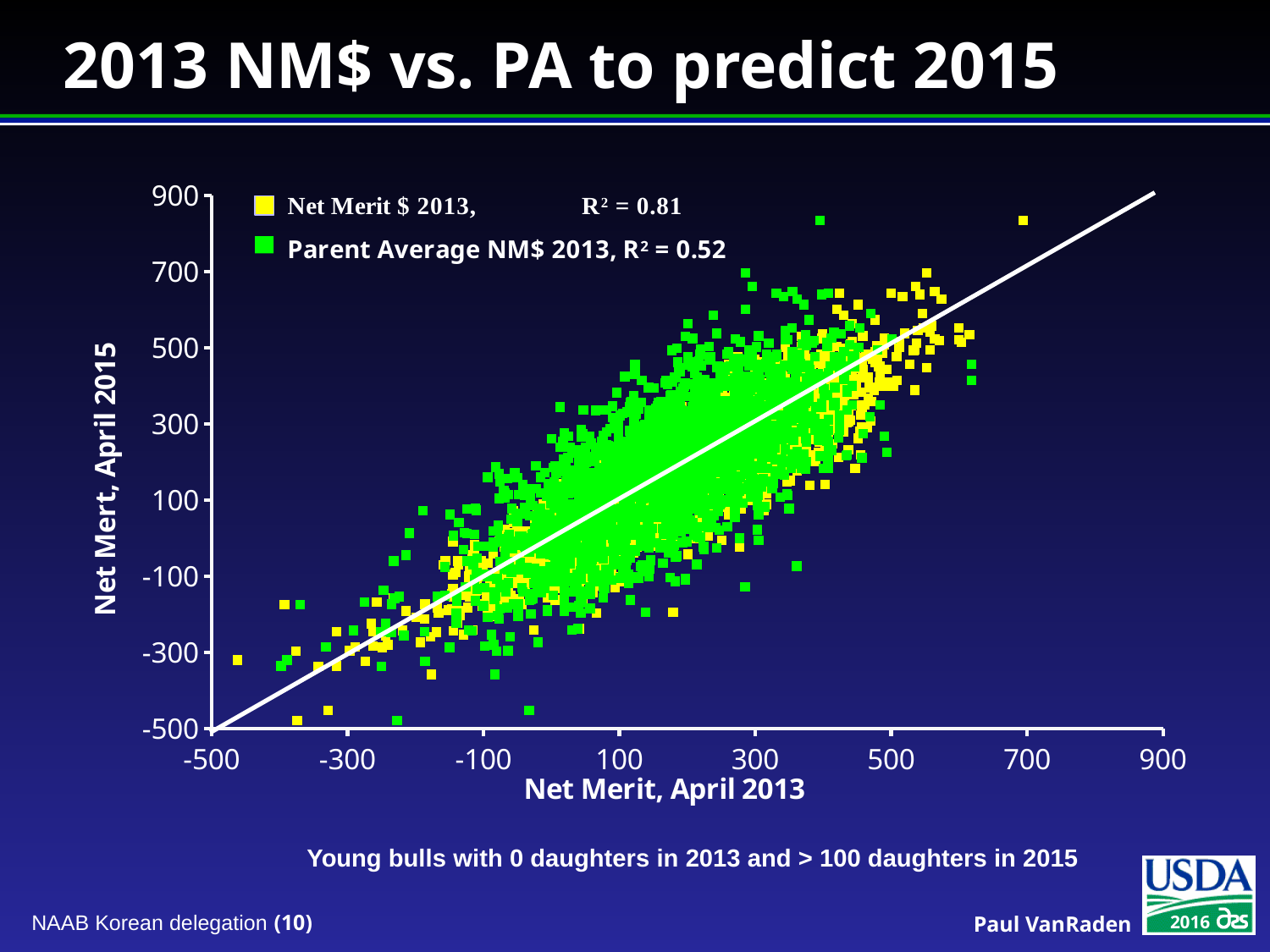
What kind of chart is shown on the slide? Scatter plot What colour are the points for the Parent Average NM$ 2013 series? Green What is the R² value shown for the Net Merit $ 2013 series? 0.81 Which series has the higher R² value, Net Merit $ 2013 or Parent Average NM$ 2013? Net Merit $ 2013 What is the lowest value labelled on the x axis? -500 What is the R² value shown for the Parent Average NM$ 2013 series? 0.52 What is the title of the x axis? Net Merit, April 2013 What is the highest value labelled on the y axis? 900 Do the plotted points generally rise or fall as the x-axis value (Net Merit, April 2013) increases? Rise What is the difference between the R² values of the two series? 0.29 How many series does the legend list? 2